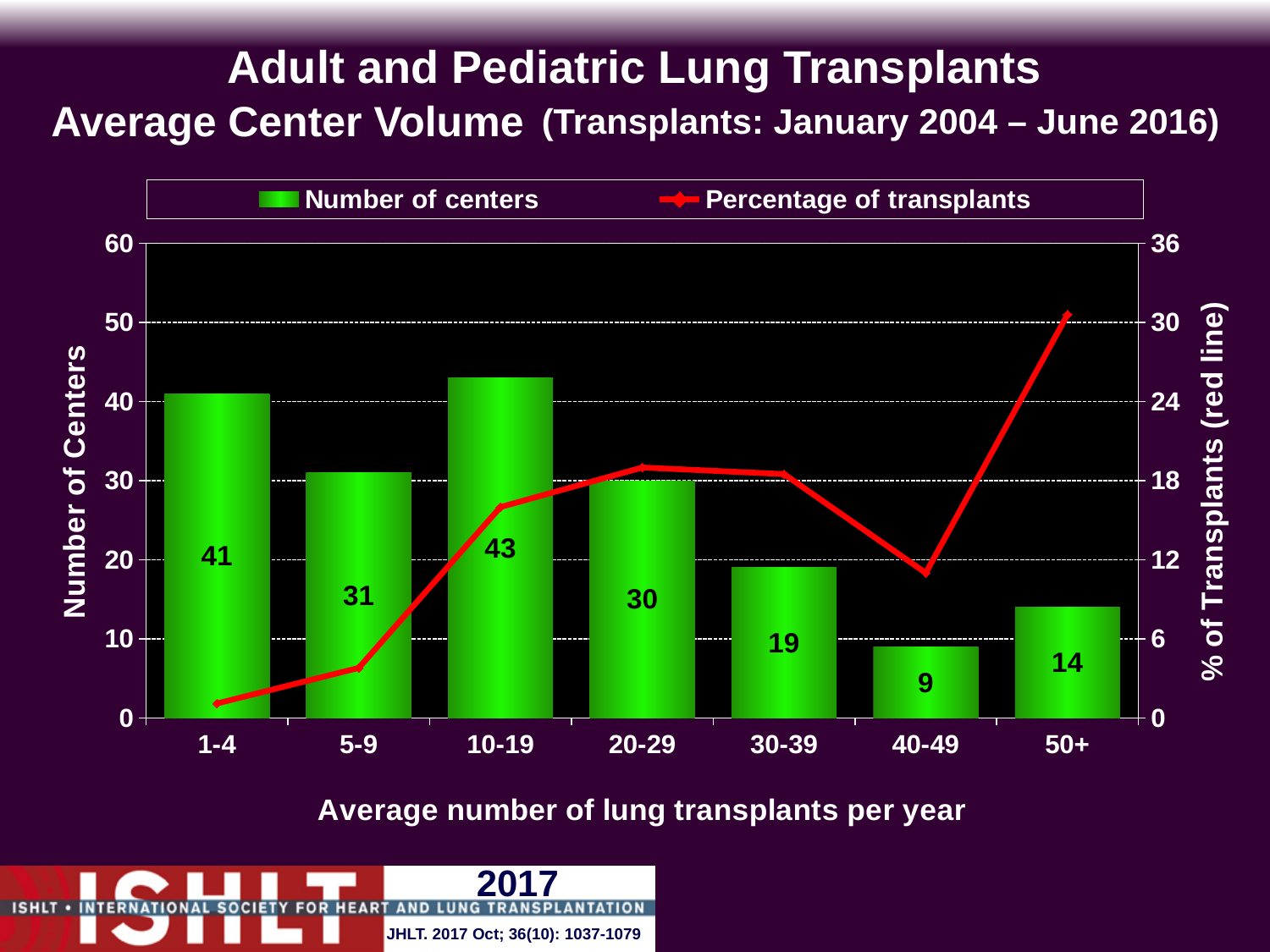
How many categories are shown on the x axis? 7 Is the percentage of transplants for the 50+ category greater or less than 24? greater Which category has the lowest number of centers? 40-49 How many centers are in the 10-19 average transplants per year category? 43 What is the difference in number of centers between the 1-4 and 5-9 categories? 10 How many series does the legend list? 2 Which has more centers, the 20-29 category or the 30-39 category? 20-29 What kind of chart is used to show the number of centers? Bar chart Is the percentage of transplants for the 5-9 category greater or less than 6? less Which category has the highest number of centers? 10-19 What is the label of the right-hand y axis? % of Transplants (red line) How many centers are in the 40-49 average transplants per year category? 9